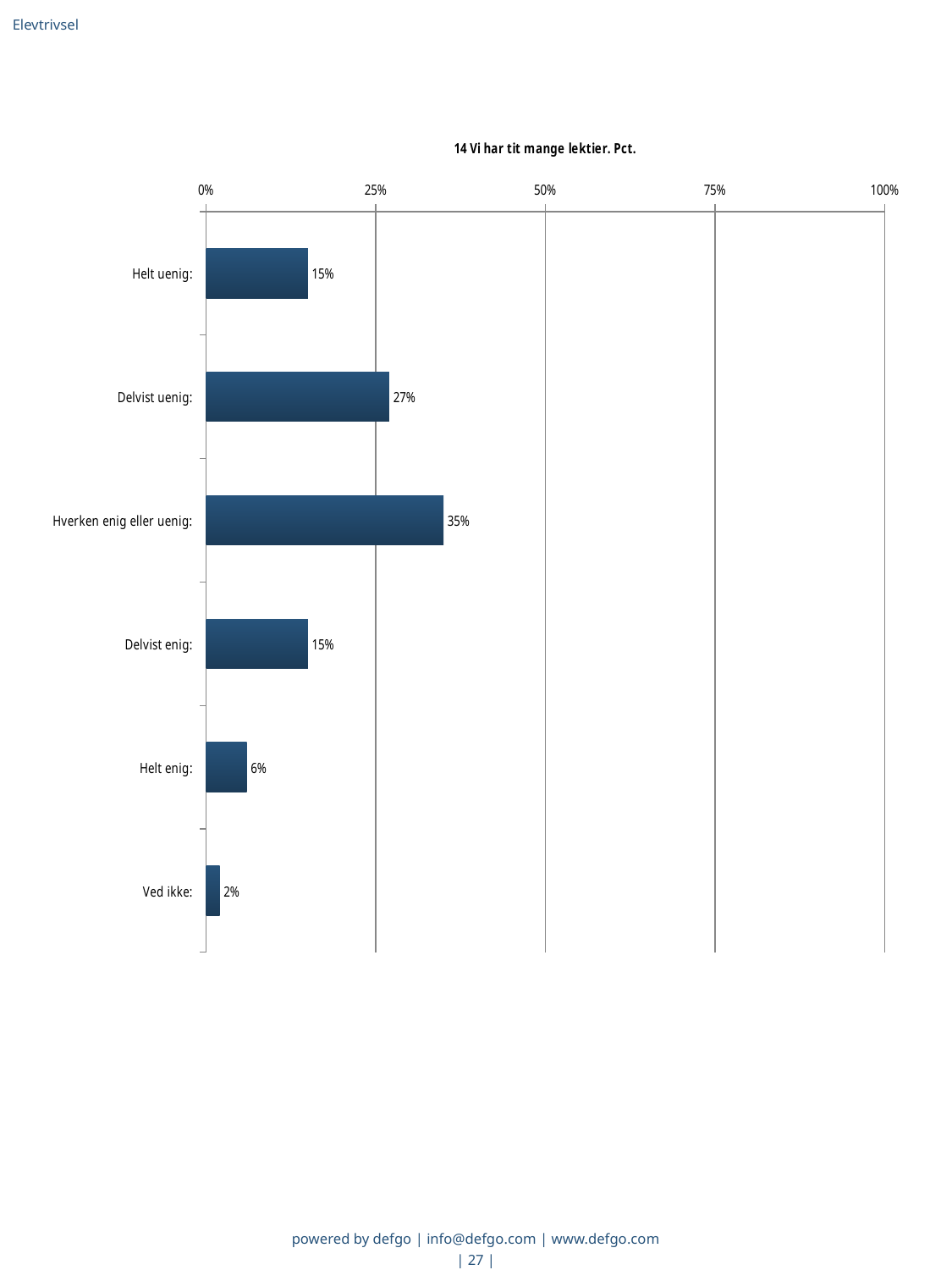
What type of chart is shown on the slide? Bar chart How many categories are shown in the chart? 6 Which category has the highest value? Hverken enig eller uenig Which is larger, the value for "Delvist uenig" or the value for "Delvist enig"? Delvist uenig What is the value for "Hverken enig eller uenig"? 35% What is the value for "Helt enig"? 6% What is the difference between the values for "Helt uenig" and "Helt enig"? 9% Which category has the lowest value? Ved ikke Is the value for "Hverken enig eller uenig" greater or less than 25%? greater What is the value for "Delvist uenig"? 27% What is the value for "Ved ikke"? 2% What is the difference between the values for "Hverken enig eller uenig" and "Delvist uenig"? 8%